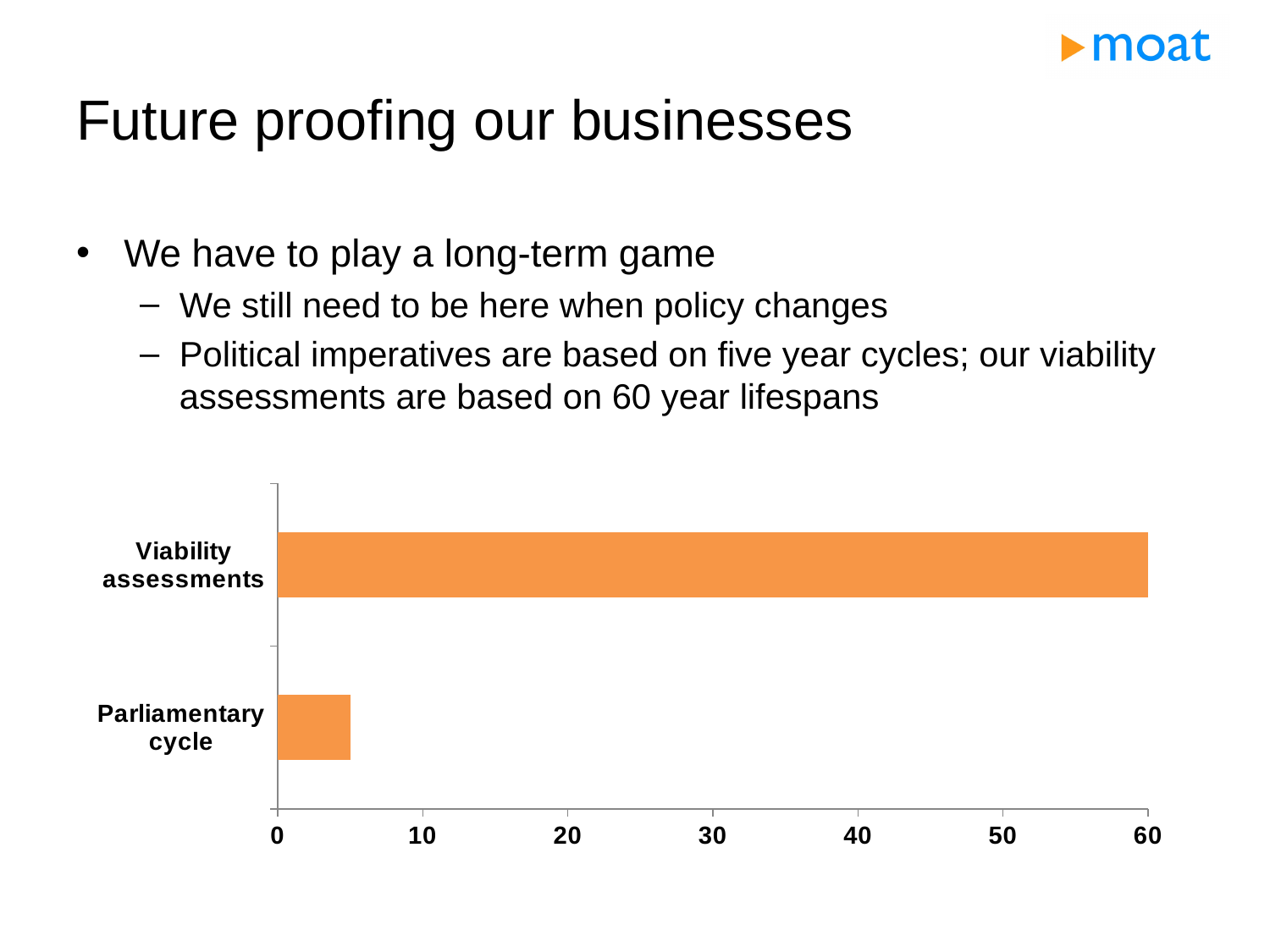
What is the highest value labelled on the horizontal axis of the chart? 60 Is the value for Parliamentary cycle greater or less than 10? less Which category has the highest value in the chart? Viability assessments Which is larger, the value for Viability assessments or the value for Parliamentary cycle? Viability assessments What is the value for Viability assessments in the chart? 60 What colour are the bars in the chart? orange What kind of chart is shown on the slide? bar chart Which category has the lowest value in the chart? Parliamentary cycle Is the value for Viability assessments greater or less than 50? greater How many categories are plotted in the chart? 2 Is the value for Parliamentary cycle greater or less than 20? less